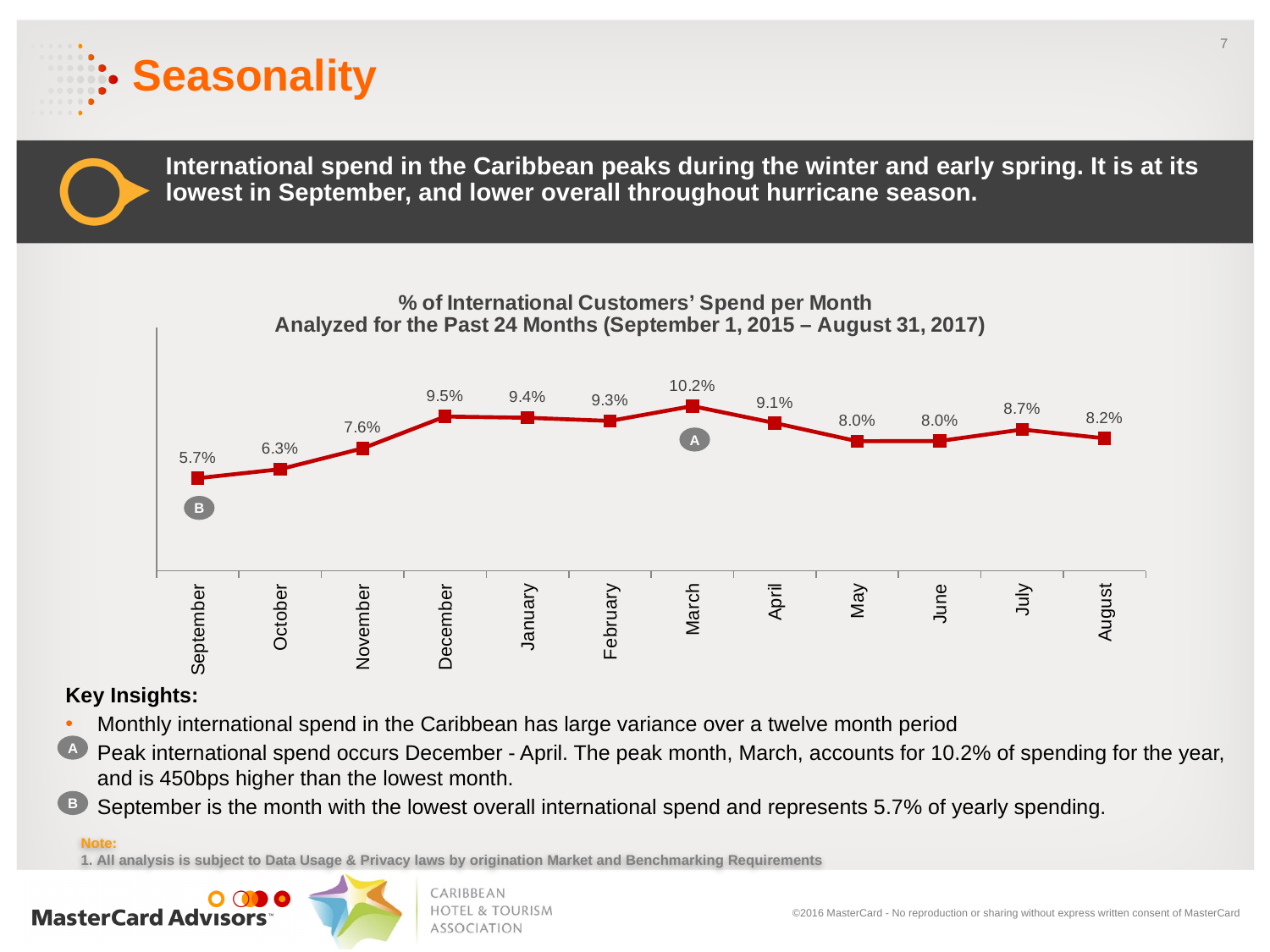
How many months are plotted on the chart? 12 What is the value for July? 8.7% What is the value for March? 10.2% What kind of chart is shown on the slide? Line chart Do the values rise or fall from September to December? Rise What is the value for September? 5.7% Which month has the lowest value? September What is the difference between the values for November and October? 1.3% What is the difference between the values for March and September? 4.5% Which month has the highest value? March Which is larger, the value for April or the value for August? April What is the value for December? 9.5%